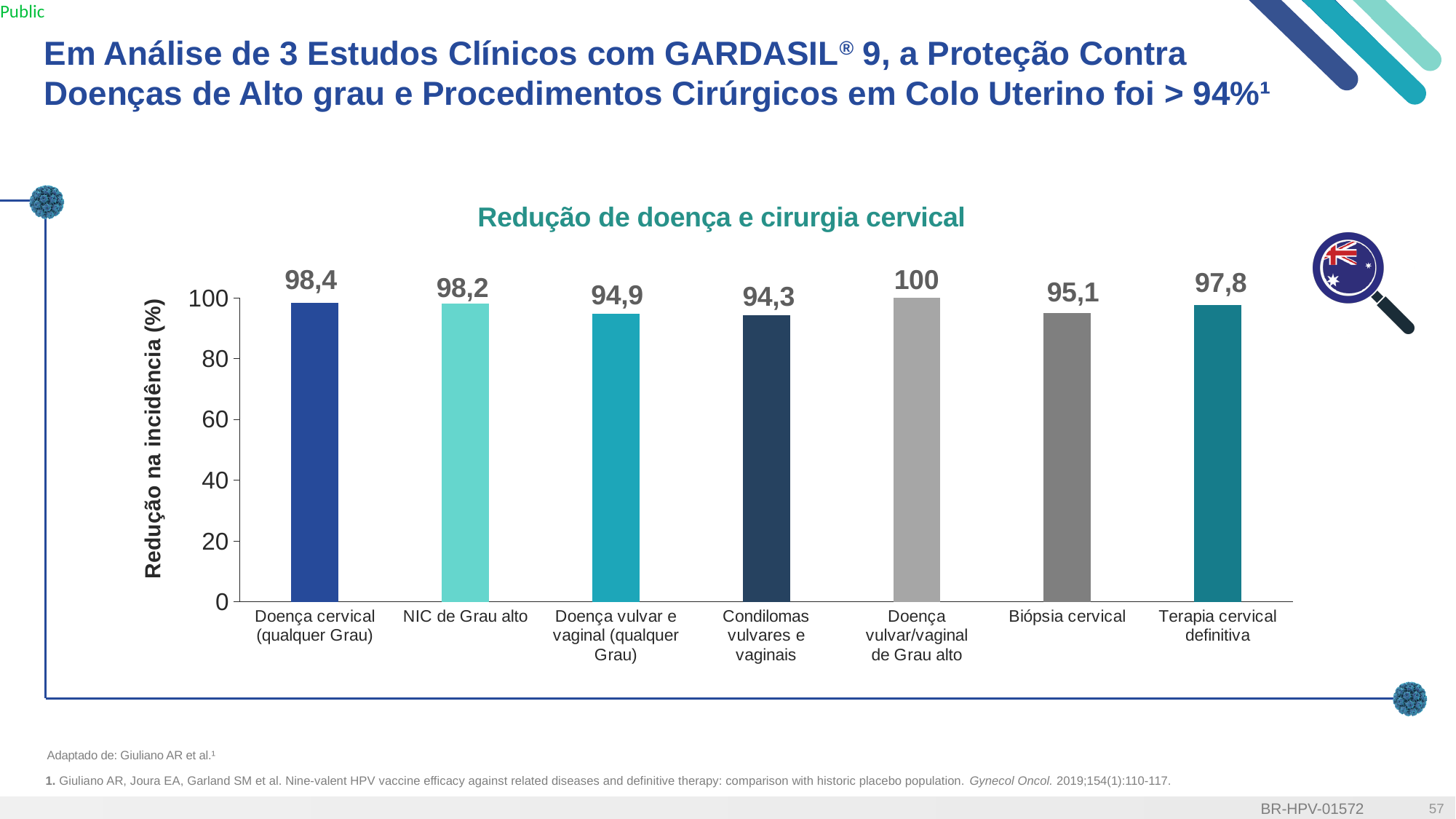
What is the value for NIC de Grau alto? 98,2 What kind of chart is shown? Bar chart What is the title of the chart? Redução de doença e cirurgia cervical What is the difference between the values for Doença cervical (qualquer Grau) and Doença vulvar e vaginal (qualquer Grau)? 3,5 What is the value for Terapia cervical definitiva? 97,8 Which is larger, the value for Biópsia cervical or the value for Terapia cervical definitiva? Terapia cervical definitiva Which category has the highest value? Doença vulvar/vaginal de Grau alto What is the value for Biópsia cervical? 95,1 How many categories are shown on the x axis? 7 What is the value for Condilomas vulvares e vaginais? 94,3 Which category has the lowest value? Condilomas vulvares e vaginais What is the label of the y axis? Redução na incidência (%)